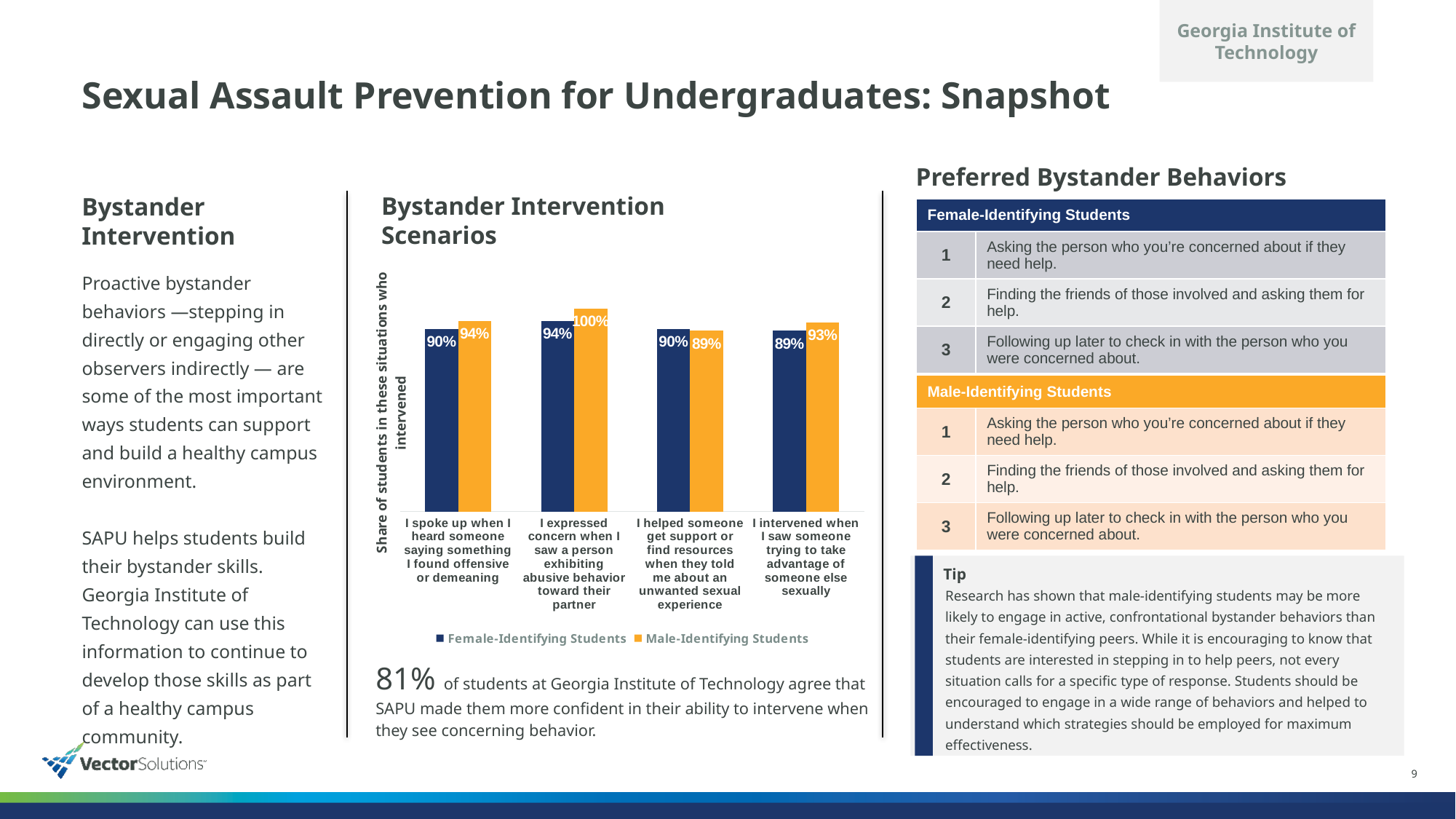
What is the value for Female-Identifying Students for 'I intervened when I saw someone trying to take advantage of someone else sexually'? 89% What kind of chart is the Bystander Intervention Scenarios chart? bar chart Which scenario has the highest value for Male-Identifying Students? I expressed concern when I saw a person exhibiting abusive behavior toward their partner What colour represents Male-Identifying Students in the Bystander Intervention Scenarios chart? orange What is the difference between the Male-Identifying and Female-Identifying values for 'I expressed concern when I saw a person exhibiting abusive behavior toward their partner'? 6% What is the value for Male-Identifying Students for 'I helped someone get support or find resources when they told me about an unwanted sexual experience'? 89% How many series does the legend of the Bystander Intervention Scenarios chart list? 2 How many scenario categories are shown on the x axis of the Bystander Intervention Scenarios chart? 4 What is the difference between the Male-Identifying and Female-Identifying values for 'I spoke up when I heard someone saying something I found offensive or demeaning'? 4% What is the value for Male-Identifying Students for 'I expressed concern when I saw a person exhibiting abusive behavior toward their partner'? 100% What is the value for Female-Identifying Students for 'I spoke up when I heard someone saying something I found offensive or demeaning'? 90% For 'I intervened when I saw someone trying to take advantage of someone else sexually', which series has the larger value, Female-Identifying Students or Male-Identifying Students? Male-Identifying Students